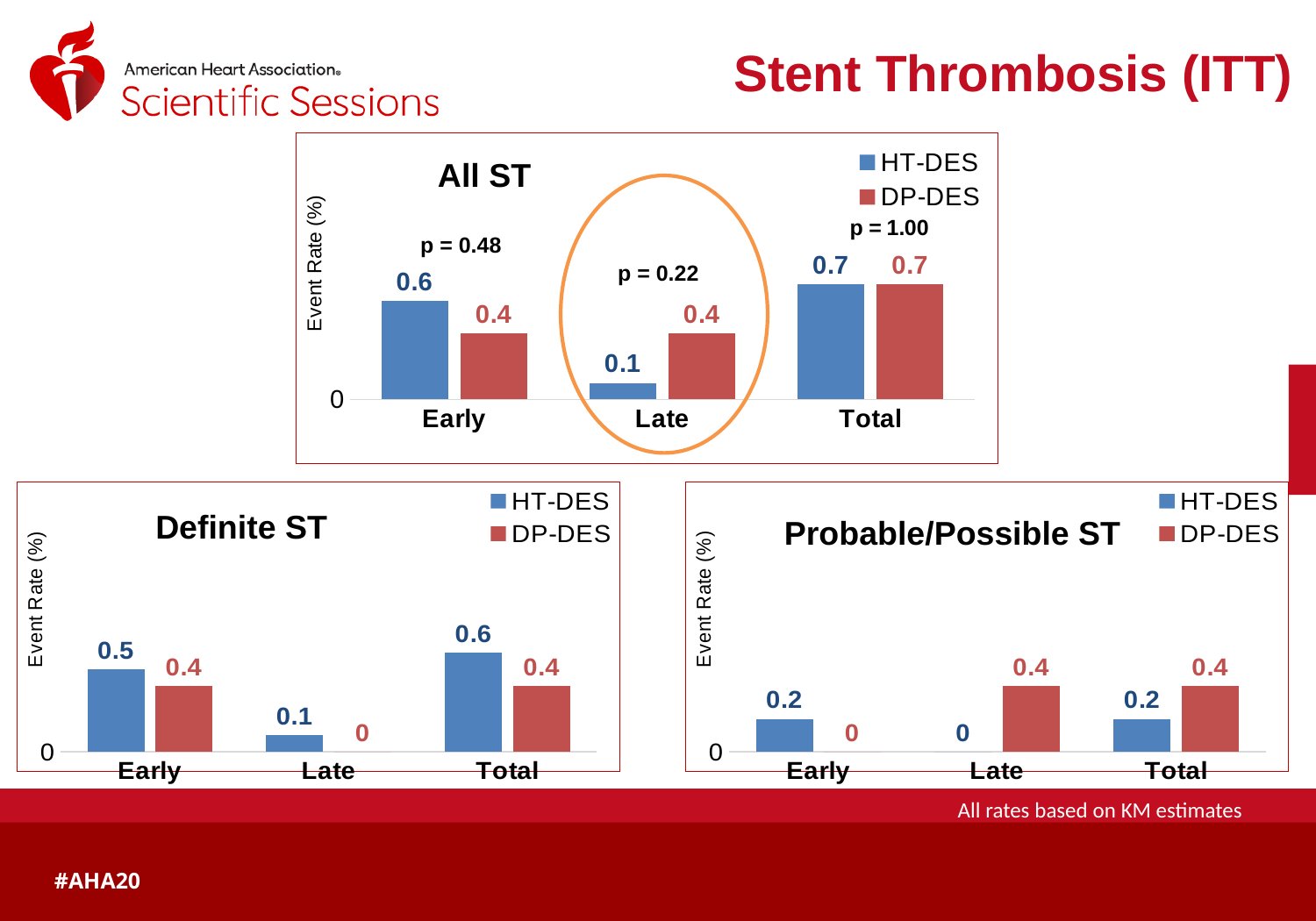
In the All ST chart, which category has the lowest HT-DES event rate? Late In the All ST chart, what is the HT-DES event rate for Early? 0.6 In the Probable/Possible ST chart, what is the HT-DES event rate for Late? 0 In the All ST chart, what p-value is shown for the Late comparison? p = 0.22 In the Definite ST chart, which is larger for Early, HT-DES or DP-DES? HT-DES In the Probable/Possible ST chart, what is the DP-DES event rate for Total? 0.4 In the All ST chart, what is the difference between the DP-DES and HT-DES event rates for Late? 0.3 In the Definite ST chart, what is the DP-DES event rate for Late? 0 What kind of chart is the Definite ST chart? Bar chart In the All ST chart, what is the DP-DES event rate for Late? 0.4 In the Definite ST chart, what is the HT-DES event rate for Total? 0.6 How many series does the legend of the Probable/Possible ST chart list? 2